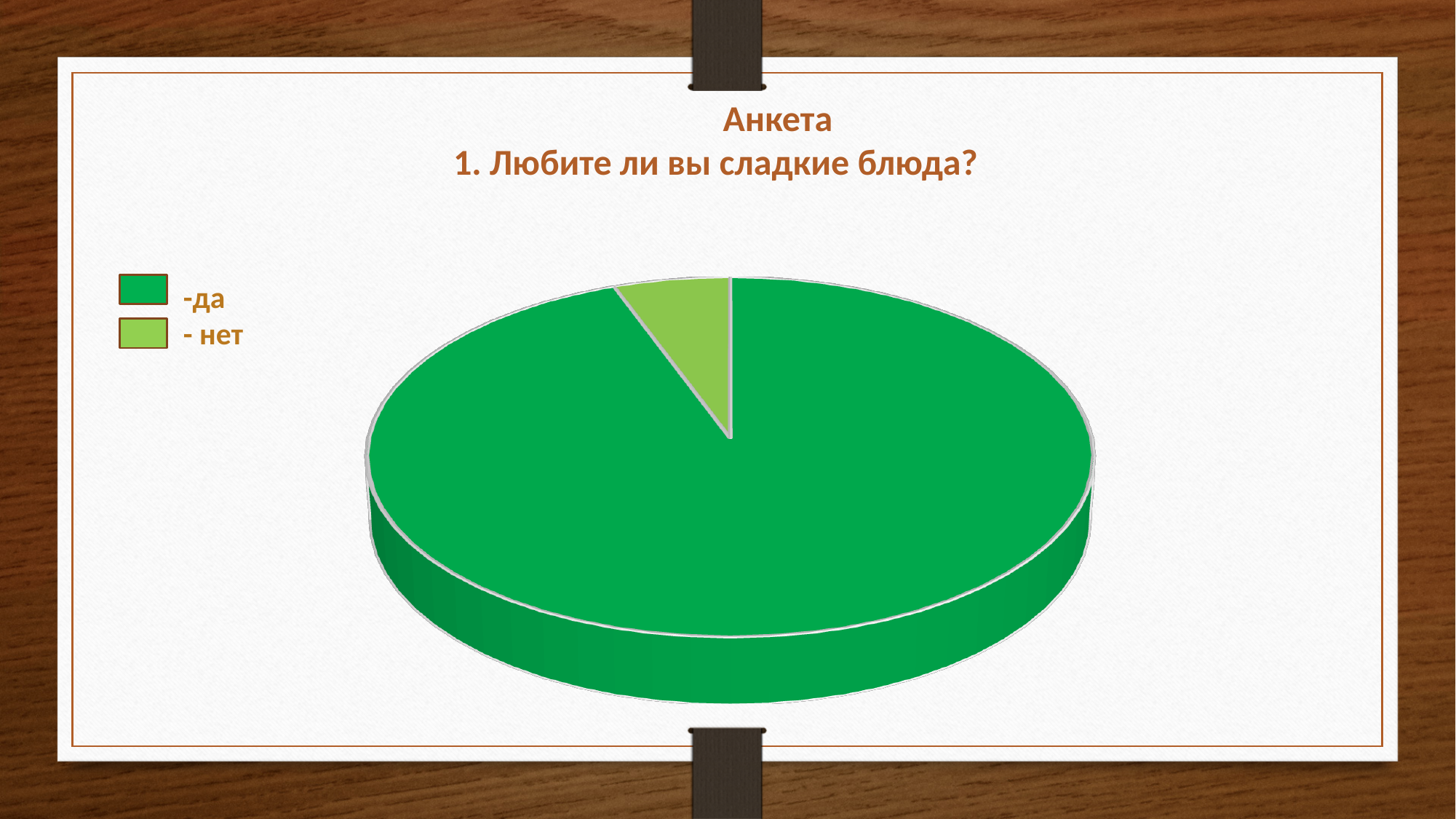
What kind of chart is shown on the slide? pie chart Which answer has the smallest slice of the pie? нет Which answer has the largest slice of the pie? да How many slices does the pie chart have? 2 Which slice is larger, "да" or "нет"? да What question is the pie chart about, according to the slide title? Любите ли вы сладкие блюда? Which legend entry is shown in the lighter green colour? нет How many entries does the legend list? 2